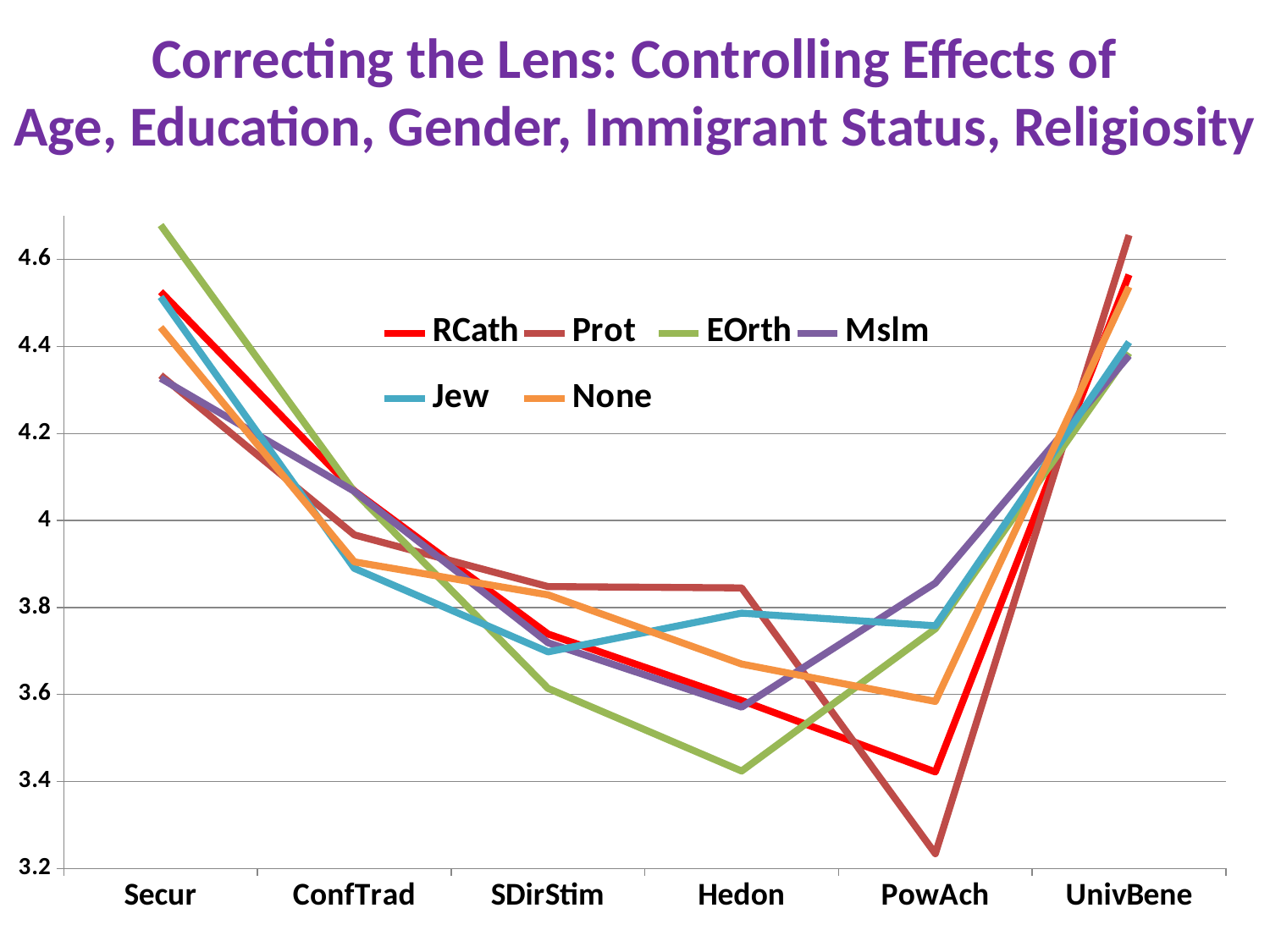
Which series has the lowest value at PowAch? Prot Is the value for Jew at ConfTrad greater or less than 4? less Does the EOrth line rise or fall from Secur to Hedon? fall Which series has the highest value at UnivBene? Prot Is the value for Prot at PowAch greater or less than 3.4? less Is the value for EOrth at Secur greater or less than 4.6? greater Which series has the highest value at Secur? EOrth Which series has the lowest value at Hedon? EOrth How many categories are shown along the x axis? 6 At PowAch, which is larger: the value for RCath or the value for Prot? RCath How many series does the legend list? 6 What kind of chart is shown on the slide? line chart